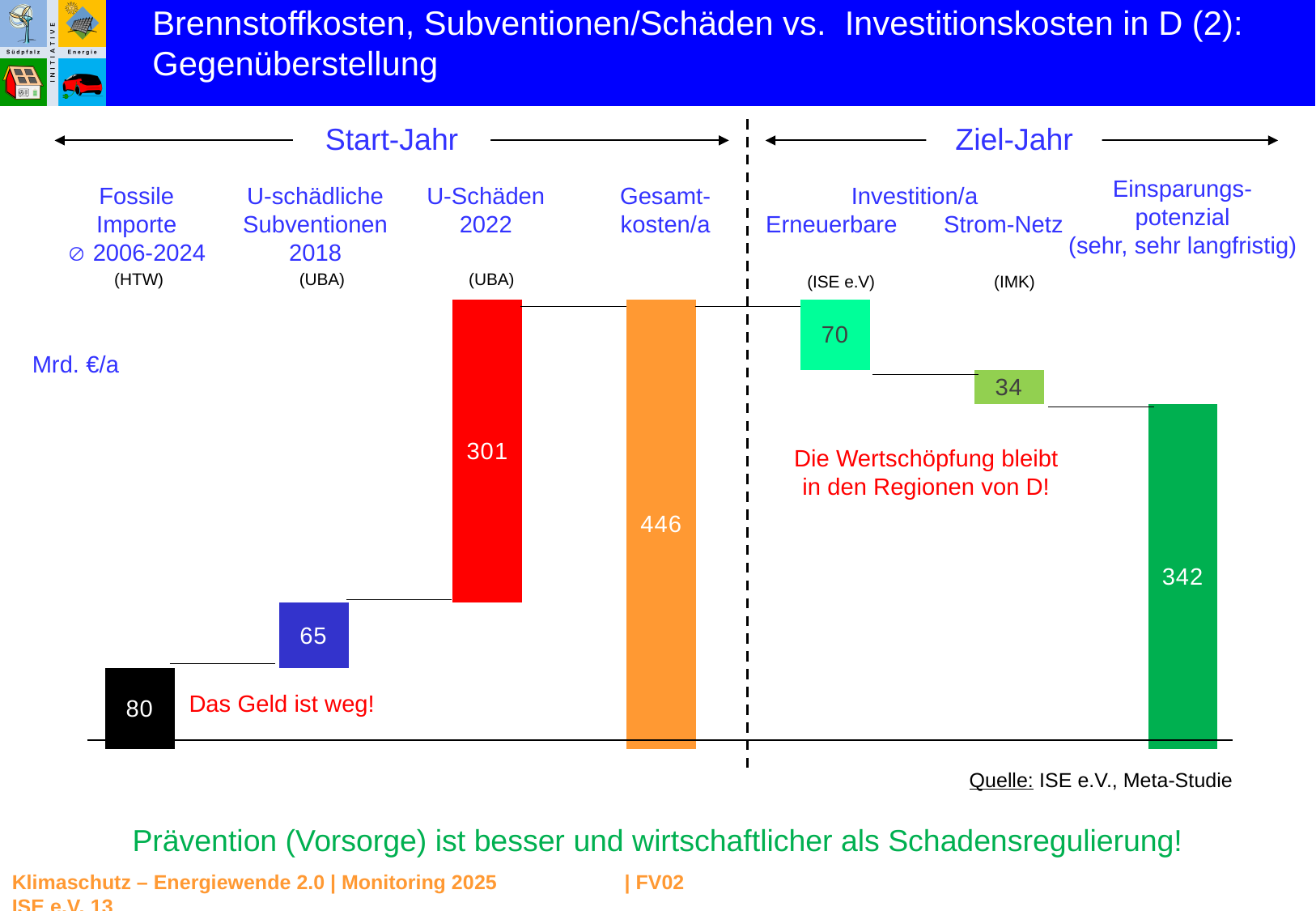
What is the value shown for Investition/a Erneuerbare? 70 Which bar has the lowest value? Investition/a Strom-Netz Which is larger, the value for Fossile Importe or the value for Investition/a Erneuerbare? Fossile Importe What is the value shown for U-Schäden 2022? 301 What is the value shown for Fossile Importe (2006-2024)? 80 What is the value shown for Gesamtkosten/a? 446 What is the value shown for Einsparungspotenzial? 342 What is the difference between U-Schäden 2022 and U-schädliche Subventionen 2018? 236 What is the value shown for U-schädliche Subventionen 2018? 65 Which bar has the highest value? Gesamtkosten/a What unit is given for the values in the chart? Mrd. €/a What is the value shown for Investition/a Strom-Netz? 34